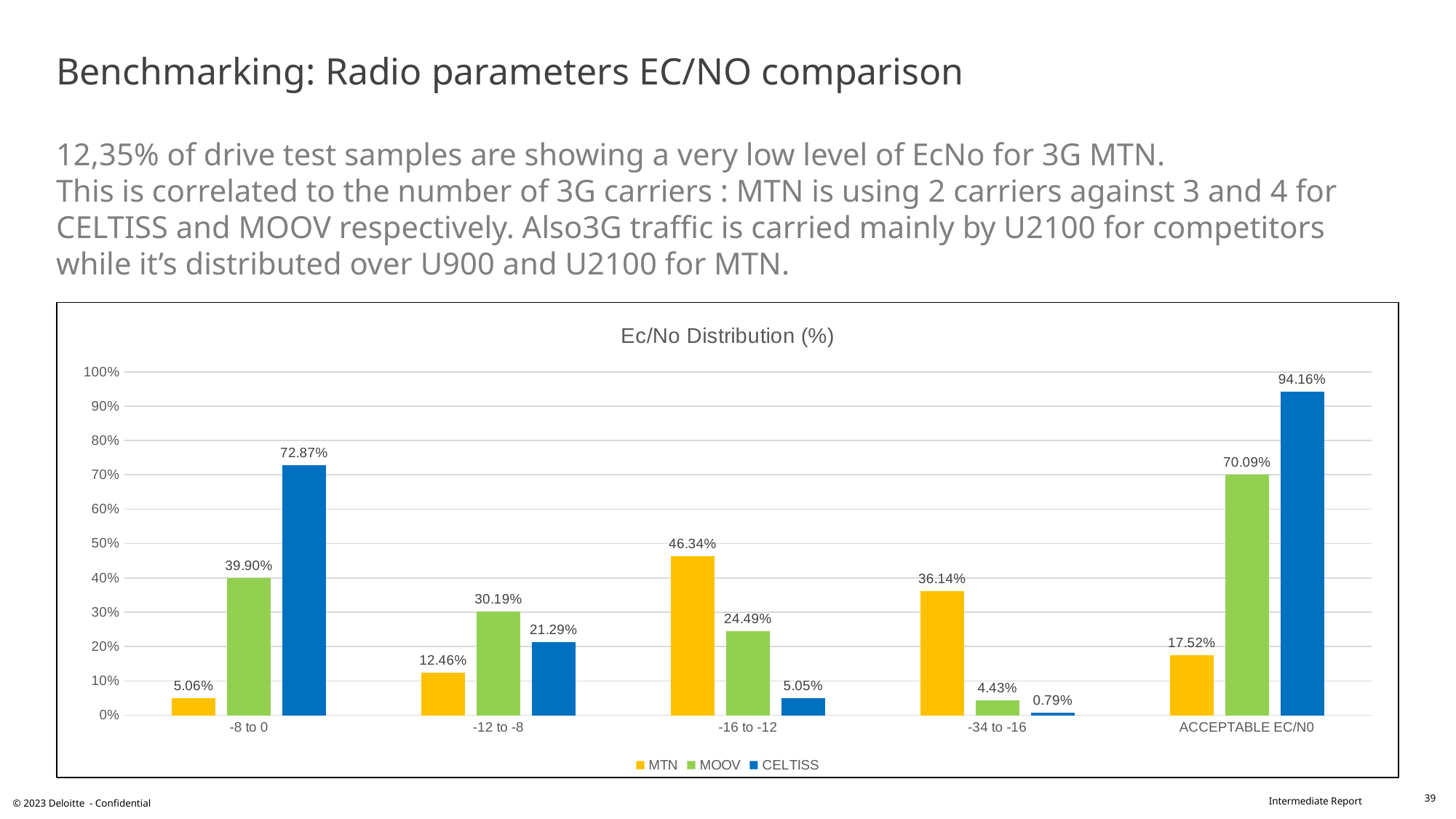
What is the value for MTN in the -34 to -16 category? 36.14% What is the difference between the CELTISS and MTN values in the ACCEPTABLE EC/N0 category? 76.64% How many series does the legend list? 3 What kind of chart is shown on the slide? Bar chart Is the value for MTN in the -16 to -12 category greater or less than 40%? greater How many categories are shown on the x axis? 5 Which series has the highest value in the ACCEPTABLE EC/N0 category? CELTISS Which series has the lowest value in the -34 to -16 category? CELTISS In the -12 to -8 category, which is larger: the MOOV value or the CELTISS value? MOOV What is the value for CELTISS in the -8 to 0 category? 72.87% What is the value for MOOV in the ACCEPTABLE EC/N0 category? 70.09% What is the title of the chart? Ec/No Distribution (%)